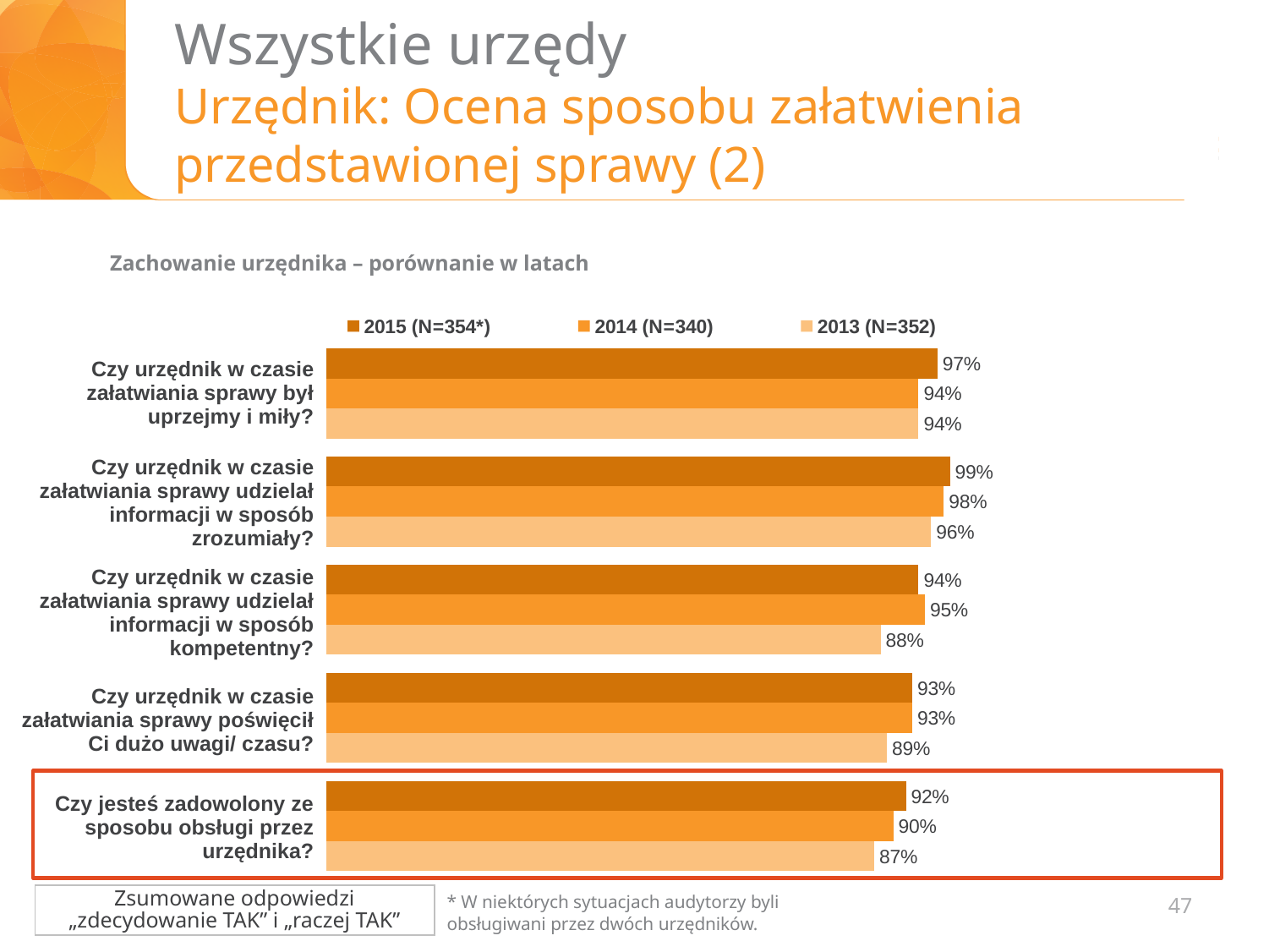
What kind of chart is shown on the slide? bar chart What is the 2014 value for "Czy urzędnik w czasie załatwiania sprawy udzielał informacji w sposób kompetentny?"? 95% What is the difference between the 2015 and 2013 values for "Czy urzędnik w czasie załatwiania sprawy udzielał informacji w sposób kompetentny?"? 6% What is the subtitle printed above the chart? Zachowanie urzędnika – porównanie w latach How many question categories are plotted on the chart? 5 How many series does the legend list? 3 What is the 2013 value for "Czy jesteś zadowolony ze sposobu obsługi przez urzędnika?"? 87% Which question category has the highest 2015 value? Czy urzędnik w czasie załatwiania sprawy udzielał informacji w sposób zrozumiały? For "Czy urzędnik w czasie załatwiania sprawy poświęcił Ci dużo uwagi/ czasu?", which is larger: the 2014 value or the 2013 value? 2014 What is the 2015 value for "Czy urzędnik w czasie załatwiania sprawy był uprzejmy i miły?"? 97% What is the sample size (N) shown in the legend for 2014? N=340 Which question category has the lowest 2013 value? Czy jesteś zadowolony ze sposobu obsługi przez urzędnika?